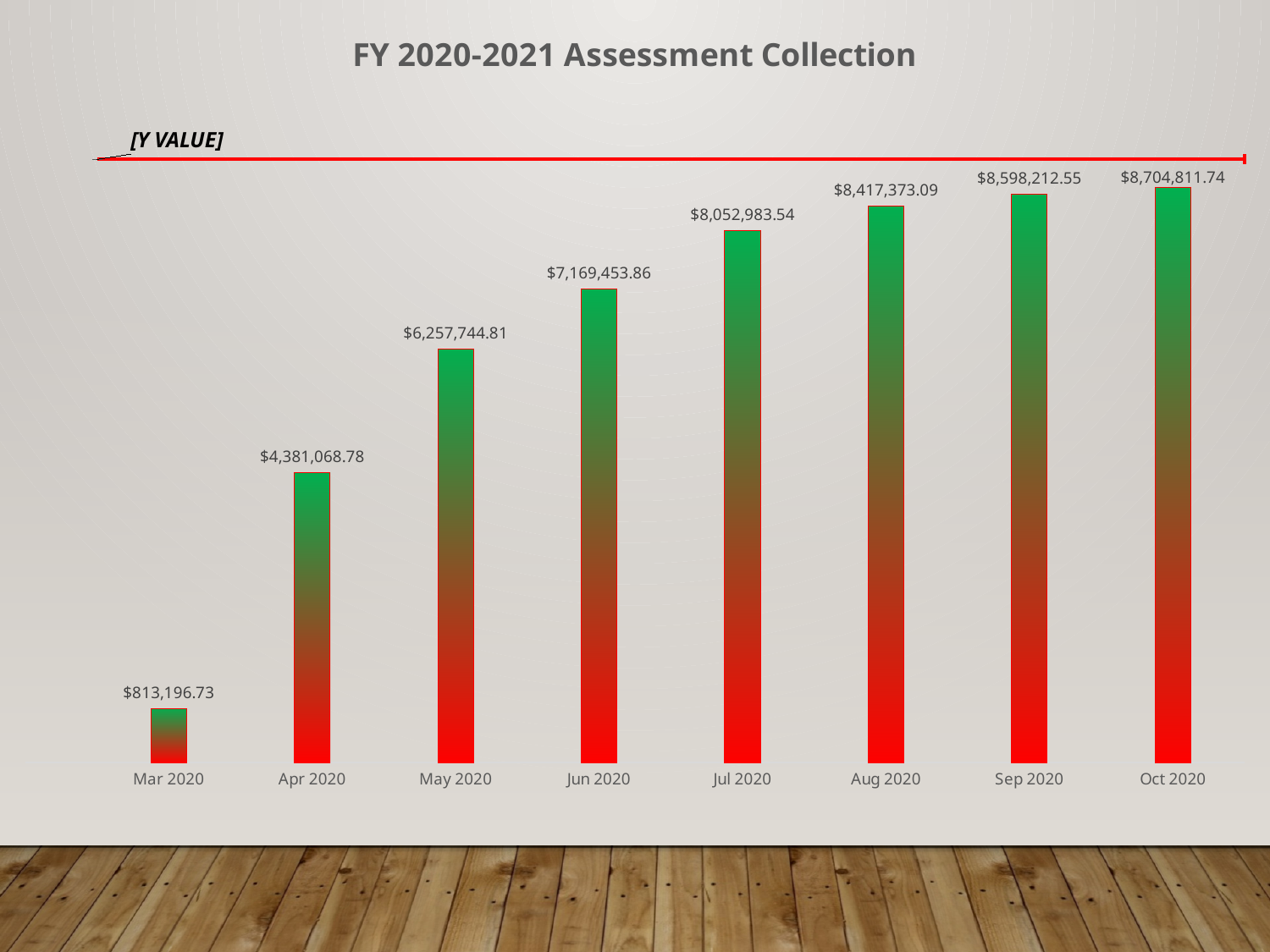
What is the value for Aug 2020? $8,417,373.09 What kind of chart is this? Bar chart What is the title of the chart? FY 2020-2021 Assessment Collection What is the difference between the values for Apr 2020 and Mar 2020? $3,567,872.05 What is the difference between the values for Oct 2020 and Sep 2020? $106,599.19 Which is larger, the value for May 2020 or the value for Jul 2020? Jul 2020 Which month has the highest assessment collection? Oct 2020 How many months are shown on the x axis? 8 Which month has the lowest assessment collection? Mar 2020 What is the value for Jun 2020? $7,169,453.86 What is the value for Mar 2020? $813,196.73 Do the bar values rise or fall from Mar 2020 to Oct 2020? Rise